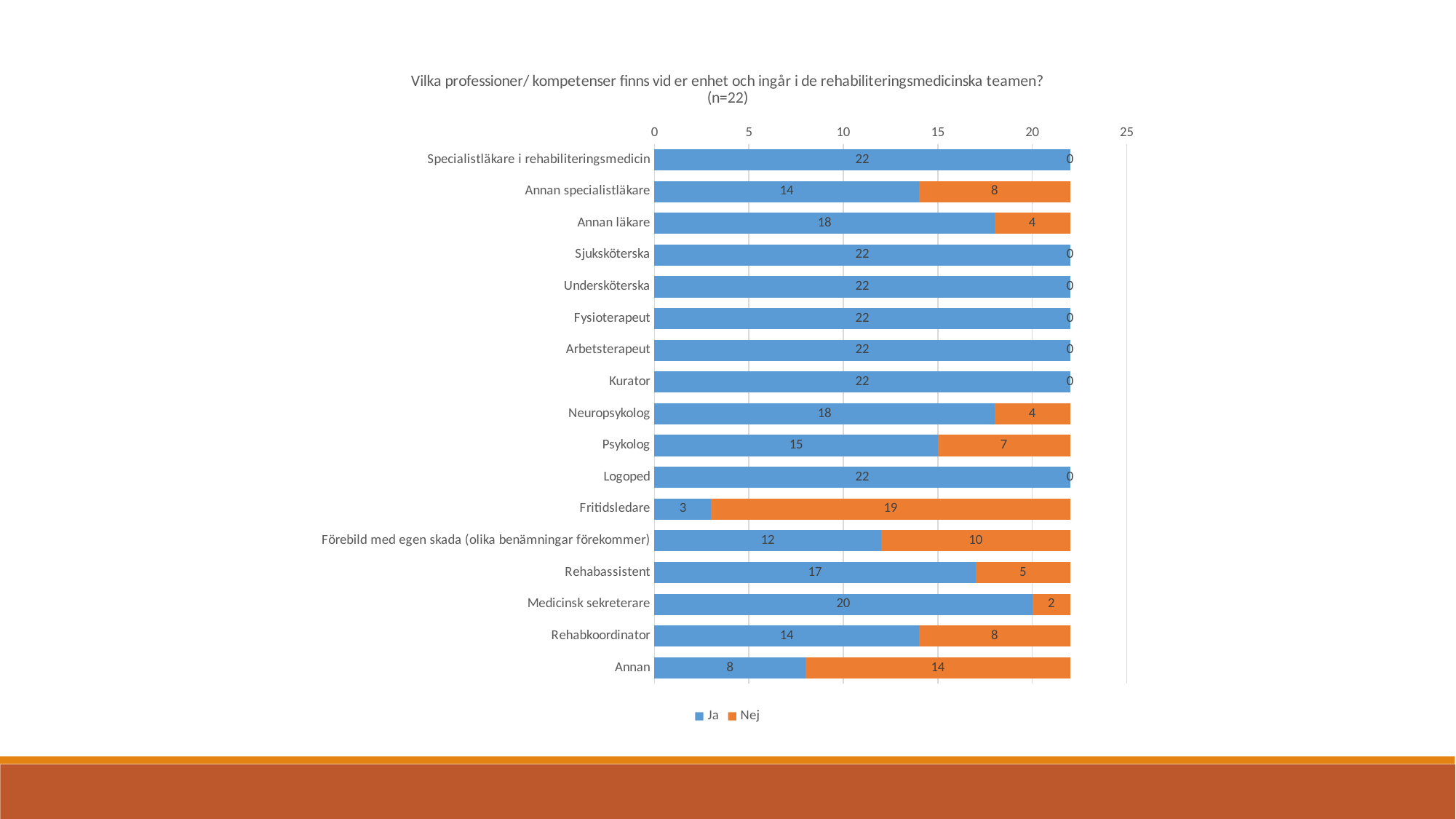
Which colour represents the "Nej" series? Orange What is the "Nej" value for Fritidsledare? 19 Which category has the highest "Nej" value? Fritidsledare What is the total of the stacked bar for Förebild med egen skada (olika benämningar förekommer)? 22 How many categories are shown on the chart? 17 How many series does the legend list? 2 Which category has the lowest "Ja" value? Fritidsledare What is the "Ja" value for Psykolog? 15 What is the "Ja" value for Medicinsk sekreterare? 20 What kind of chart is shown on the slide? Stacked bar chart What is the difference between the "Ja" and "Nej" values for Annan? 6 Which is larger, the "Ja" value for Rehabassistent or the "Ja" value for Rehabkoordinator? Rehabassistent